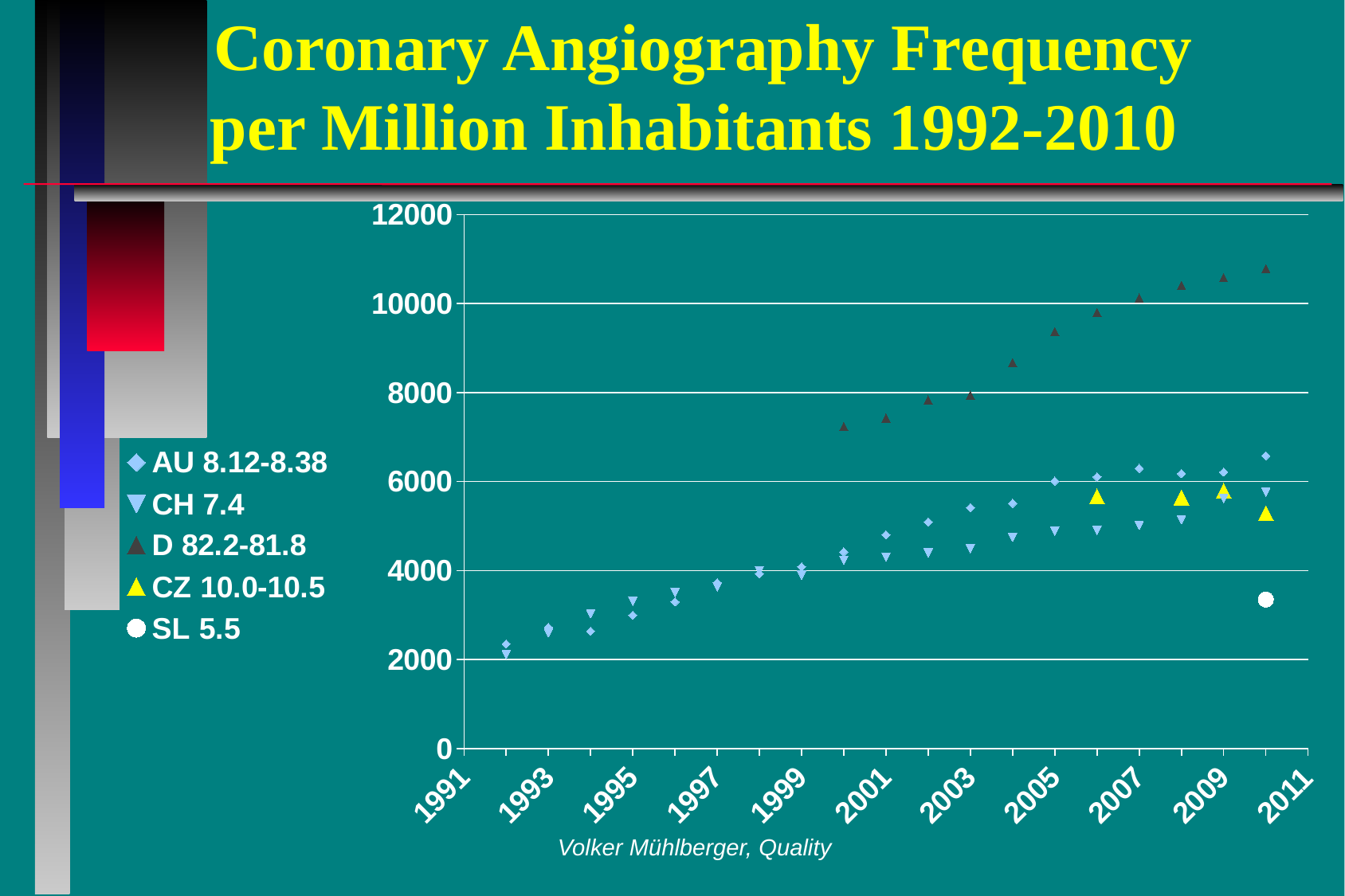
What kind of chart is shown on the slide? scatter chart Which series has the highest value in 2010? D What is the title of the chart? Coronary Angiography Frequency per Million Inhabitants 1992-2010 How many series does the legend list? 5 Which is larger in 2010, the value for AU or the value for CH? AU Is the value for SL in 2010 greater or less than 4000? less Which series has the lowest value in 2010? SL Is the value for D in 2001 greater or less than 8000? less Do the values for D rise or fall from 2001 to 2010? rise Is the value for AU in 2010 greater or less than 6000? greater Which series is plotted with yellow triangles? CZ